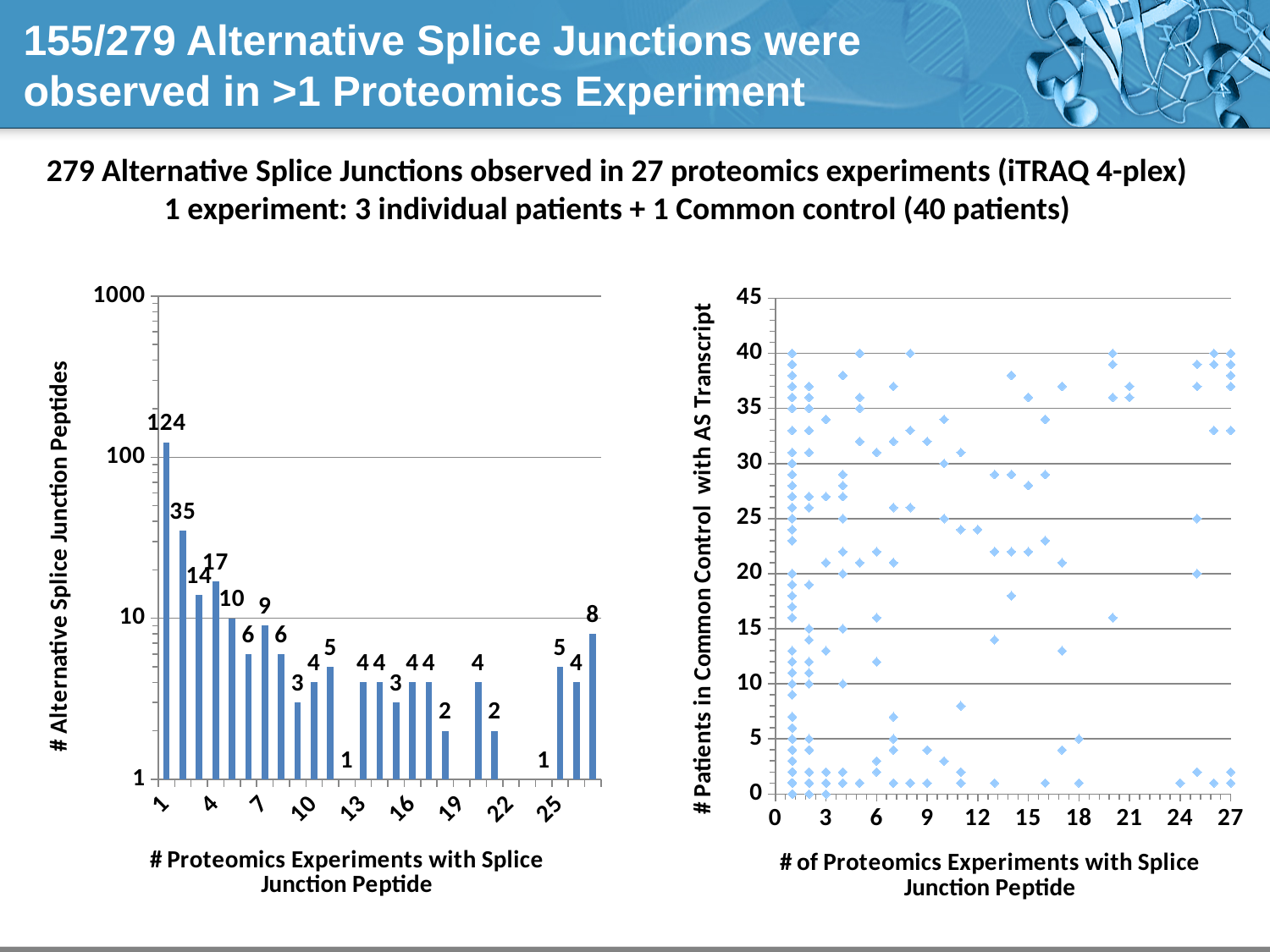
In the left bar chart, what is the value for 5 proteomics experiments? 10 What kind of chart is the left chart? bar chart In the left bar chart, what is the difference between the values for 1 experiment and 2 experiments? 89 In the left bar chart, how many alternative splice junction peptides were observed in exactly 1 proteomics experiment? 124 What is the highest value shown on the y axis of the right chart? 45 What is the y-axis label of the right chart? # Patients in Common Control with AS Transcript In the left bar chart, what is the value for 2 proteomics experiments? 35 In the left bar chart, which is larger: the value for 3 experiments or the value for 4 experiments? 4 experiments In the left bar chart, do the values generally rise or fall as the number of proteomics experiments increases from 1 to 12? fall In the left bar chart, which number of proteomics experiments has the highest number of alternative splice junction peptides? 1 In the left bar chart, what is the value for 27 proteomics experiments? 8 What kind of chart is the right chart? scatter plot